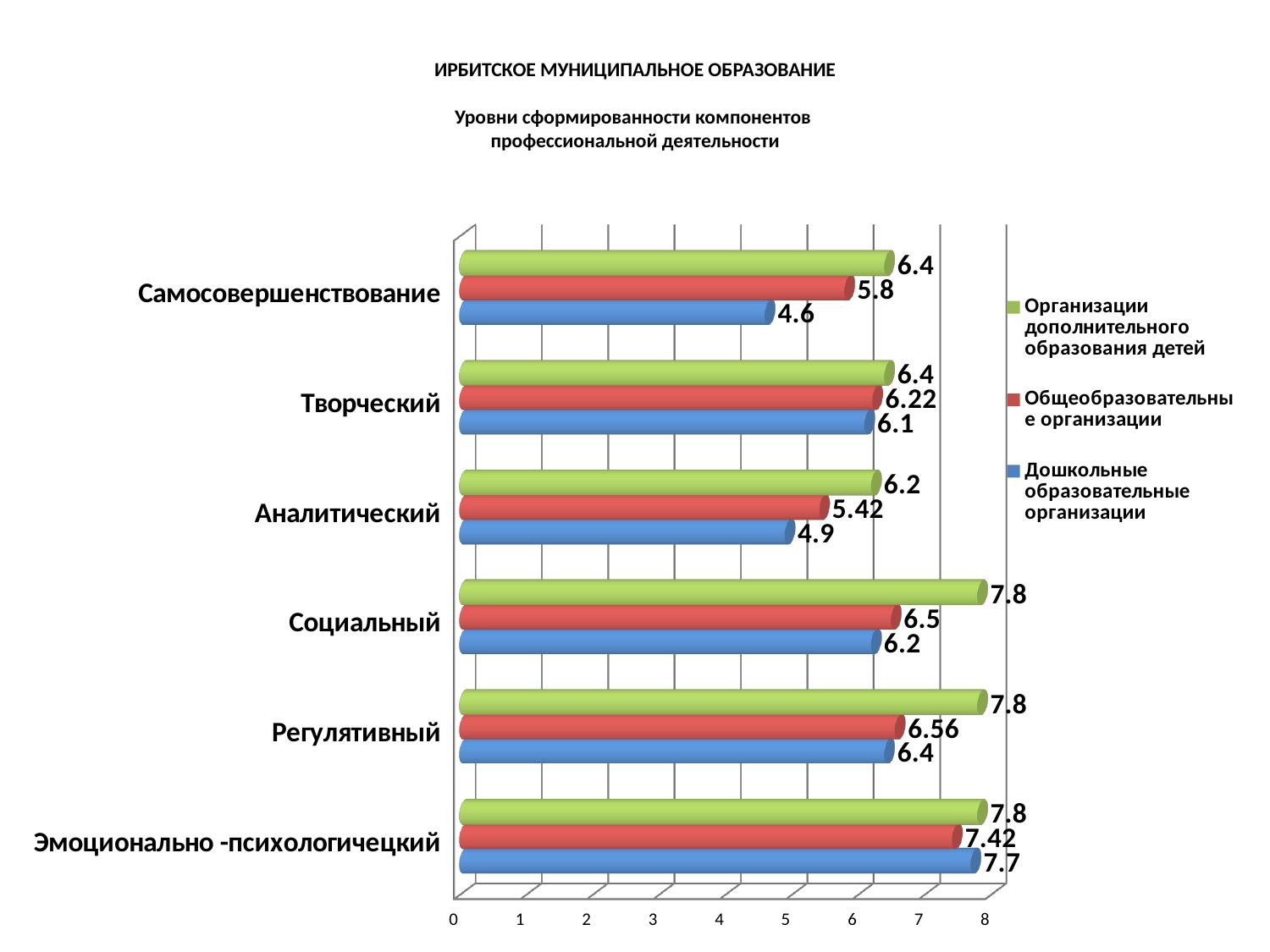
What is the value for Дошкольные образовательные организации in the Самосовершенствование category? 4.6 Which category has the highest value for Общеобразовательные организации? Эмоционально -психологичецкий What is the value for Организации дополнительного образования детей in the Творческий category? 6.4 Which colour represents Общеобразовательные организации in the chart? Red Which category has the lowest value for Дошкольные образовательные организации? Самосовершенствование What is the difference between the Организации дополнительного образования детей value and the Дошкольные образовательные организации value in the Социальный category? 1.6 What kind of chart is shown on the slide? Bar chart In the Эмоционально -психологичецкий category, which is larger: the value for Общеобразовательные организации or the value for Дошкольные образовательные организации? Дошкольные образовательные организации What is the value for Общеобразовательные организации in the Регулятивный category? 6.56 What is the value for Общеобразовательные организации in the Аналитический category? 5.42 How many series does the legend list? 3 How many categories are shown on the chart? 6